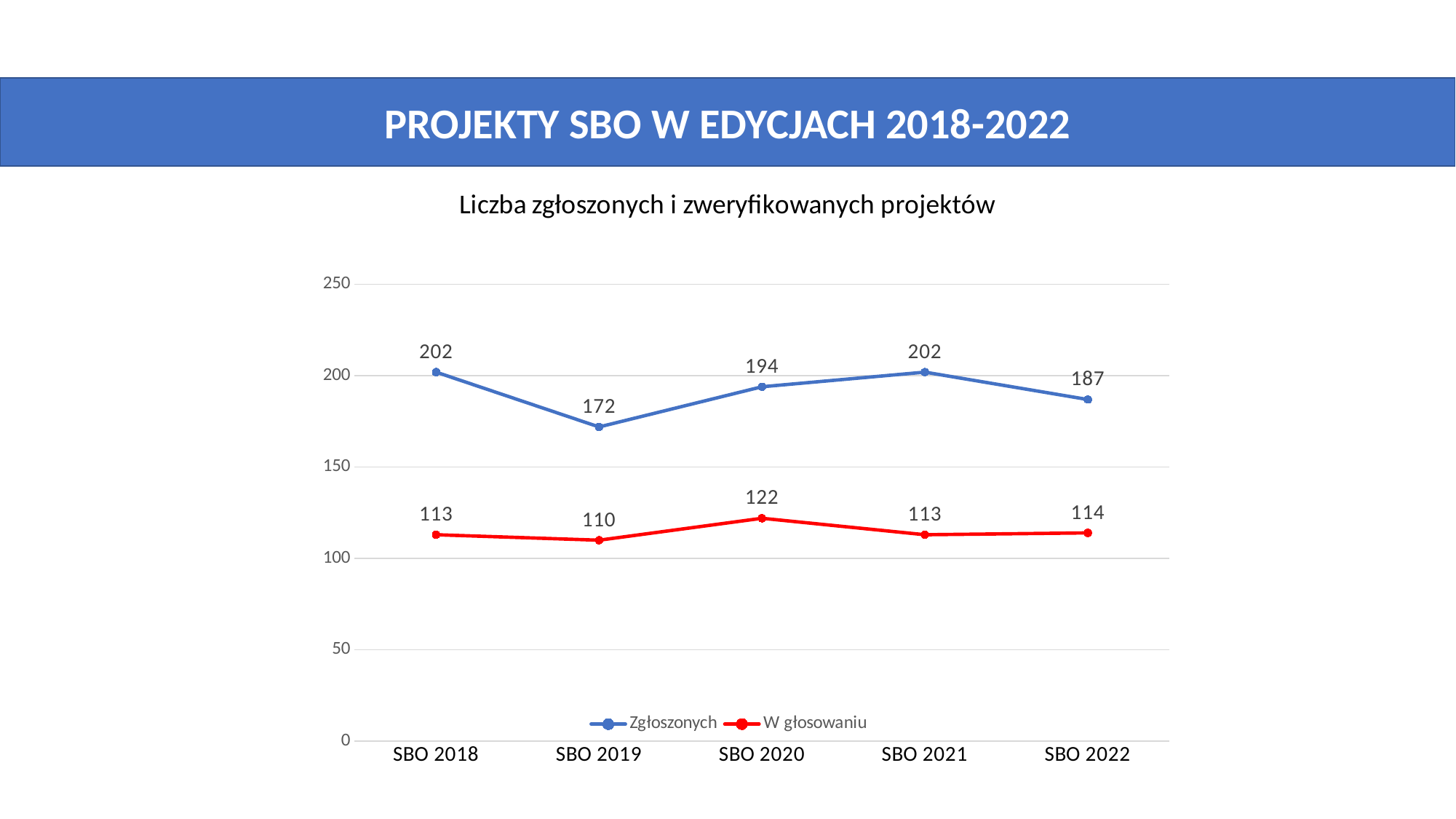
What is the value for Zgłoszonych in SBO 2022? 187 Does the Zgłoszonych series rise or fall from SBO 2021 to SBO 2022? fall What is the difference between Zgłoszonych and W głosowaniu in SBO 2018? 89 What is the value for Zgłoszonych in SBO 2019? 172 What kind of chart is shown? line chart Which is larger: W głosowaniu in SBO 2019 or W głosowaniu in SBO 2022? SBO 2022 What is the value for W głosowaniu in SBO 2020? 122 What is the title of the chart? Liczba zgłoszonych i zweryfikowanych projektów How many editions are shown on the x axis? 5 How many series does the legend list? 2 In which edition is the W głosowaniu value highest? SBO 2020 In which edition is the Zgłoszonych value lowest? SBO 2019